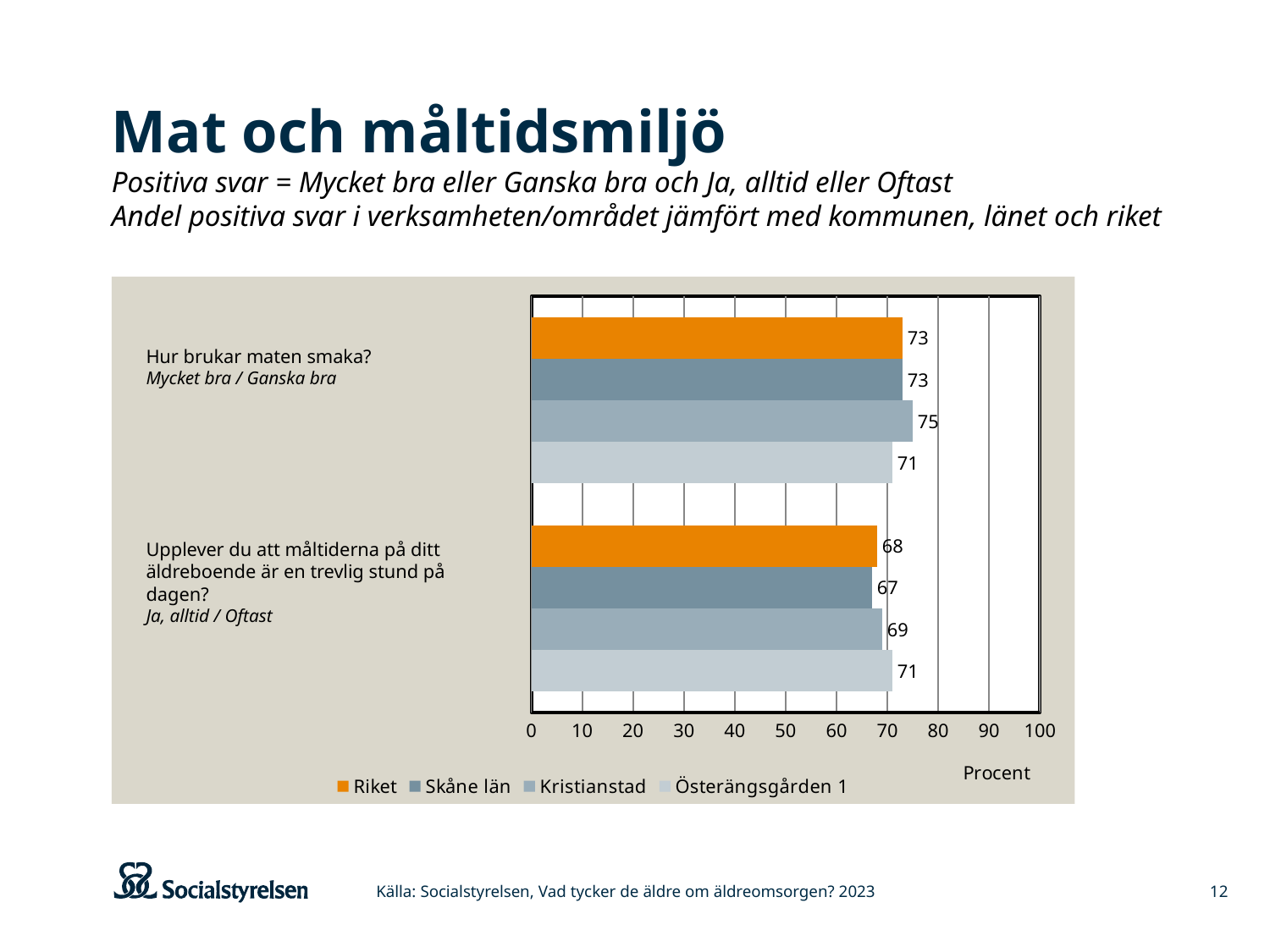
Which series has the lowest value for the question "Upplever du att måltiderna på ditt äldreboende är en trevlig stund på dagen?"? Skåne län For the question "Upplever du att måltiderna på ditt äldreboende är en trevlig stund på dagen?", which is larger: the value for Österängsgården 1 or the value for Riket? Österängsgården 1 How many series does the legend list? 4 What is the label on the horizontal axis of the chart? Procent How many question categories are shown on the chart? 2 What is the value for Österängsgården 1 for the question "Hur brukar maten smaka?"? 71 Which series has the highest value for the question "Hur brukar maten smaka?"? Kristianstad What is the value for Riket for the question "Upplever du att måltiderna på ditt äldreboende är en trevlig stund på dagen?"? 68 What kind of chart is shown on the slide? Bar chart What is the value for Kristianstad for the question "Hur brukar maten smaka?"? 75 What is the difference between the Kristianstad and Österängsgården 1 values for the question "Hur brukar maten smaka?"? 4 What is the value for Skåne län for the question "Upplever du att måltiderna på ditt äldreboende är en trevlig stund på dagen?"? 67